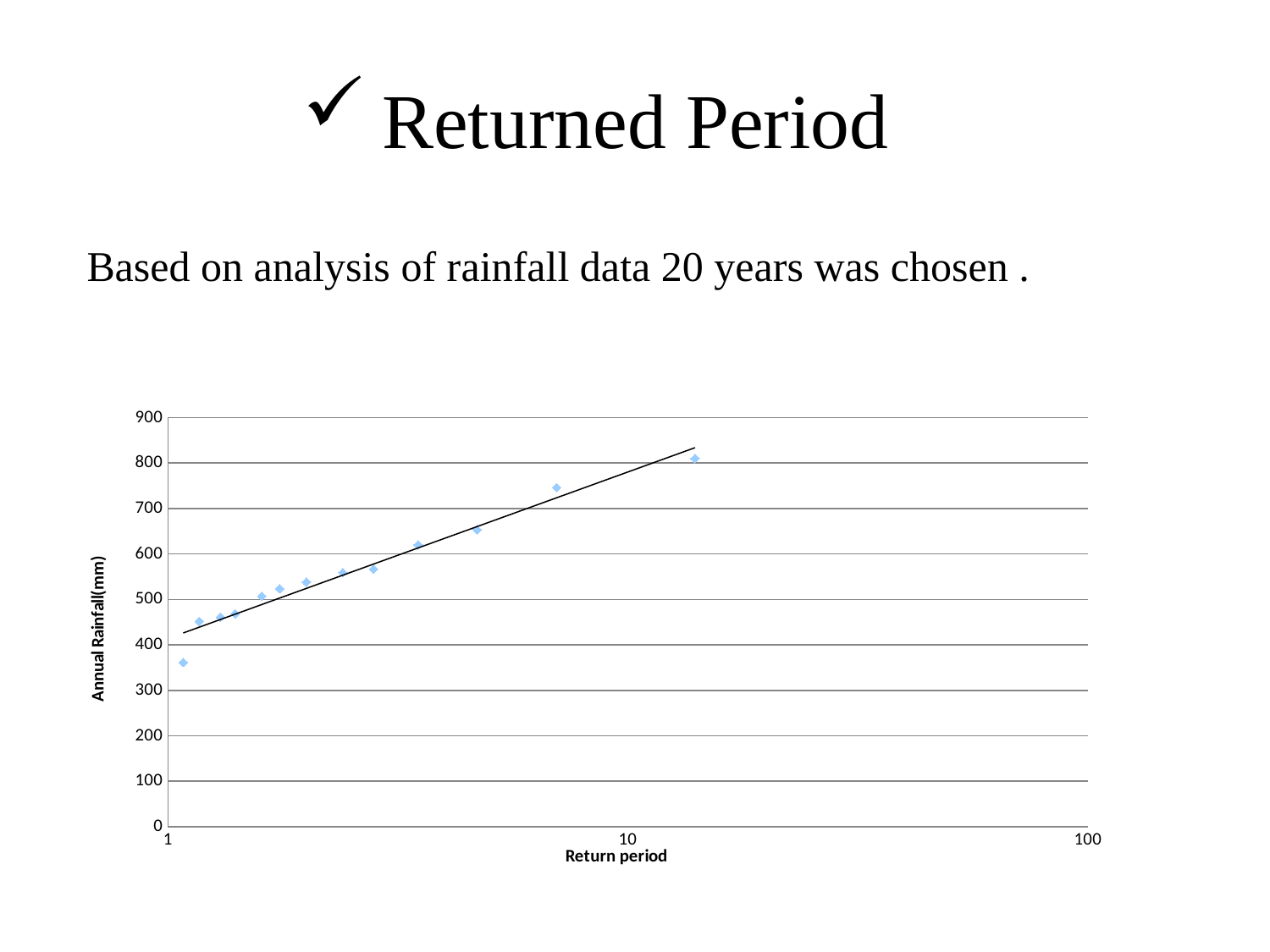
Which has the larger annual rainfall value: the point with the smallest return period or the point with the largest return period? the point with the largest return period Do the annual rainfall values rise or fall as the return period increases? rise Is the annual rainfall value for the point with the largest return period greater or less than 700? greater How many data points are plotted on the chart? 13 Is the annual rainfall value for the point with the smallest return period greater or less than 400? less Is the annual rainfall value for the point at a return period of about 5 greater or less than 600? greater What kind of chart is shown on the slide? scatter chart What is the largest value shown on the horizontal axis of the chart? 100 What is the title of the horizontal axis of the chart? Return period What is the title of the vertical axis of the chart? Annual Rainfall(mm) What is the highest value shown on the vertical axis of the chart? 900